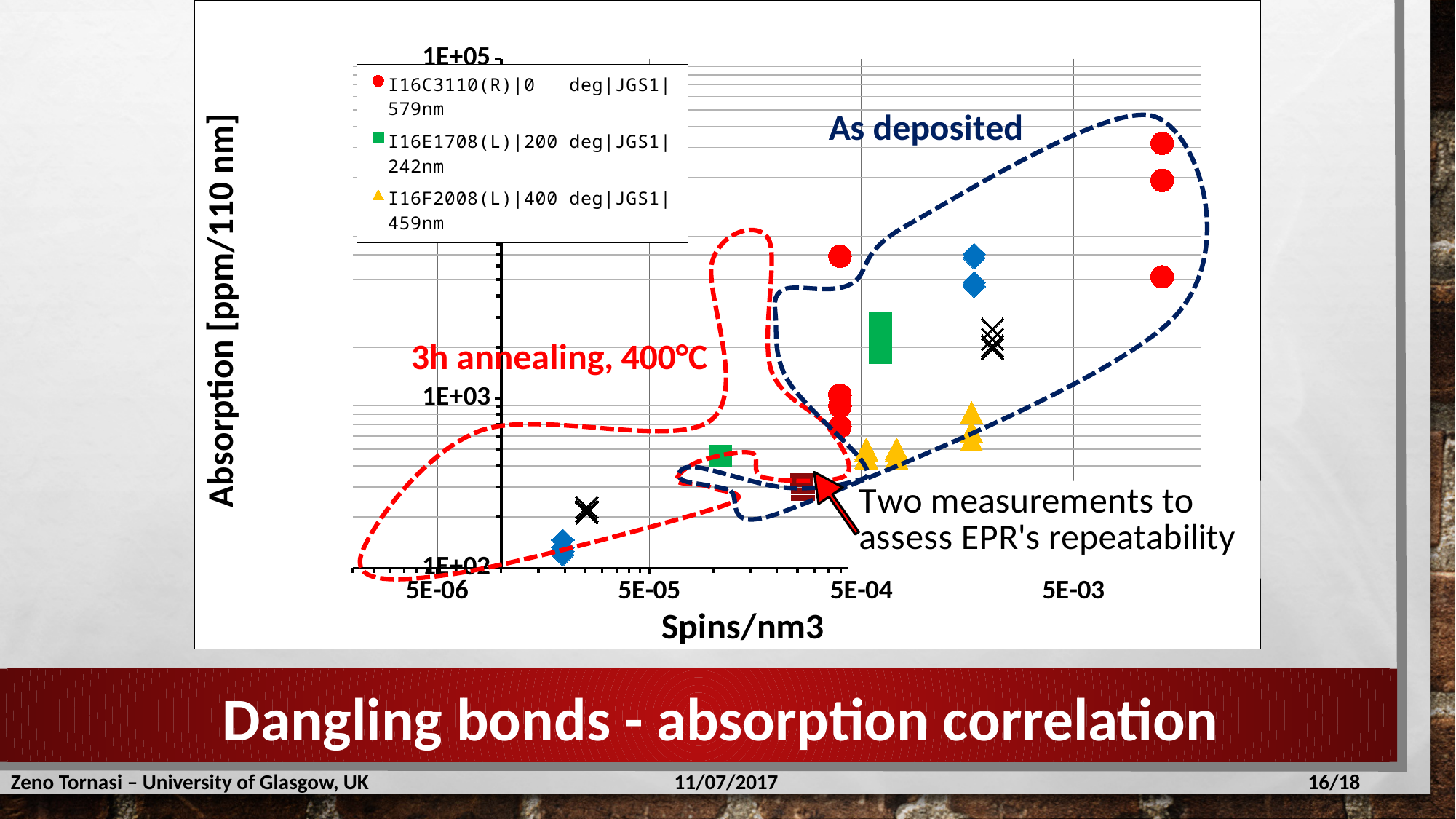
Are the absorption values of the two highest red circles (I16C3110(R)) greater or less than 1E+04? greater How many series does the chart's legend list? 3 What kind of chart is shown on the slide? Scatter chart Are the spins/nm3 values of the red circles at the far right of the chart greater or less than 5E-03? greater Is the absorption value of the green square near 5E-04 spins/nm3 greater or less than 1E+03? greater What label is written inside the blue dashed outline in the upper right of the chart? As deposited What is the label of the x axis of the chart? Spins/nm3